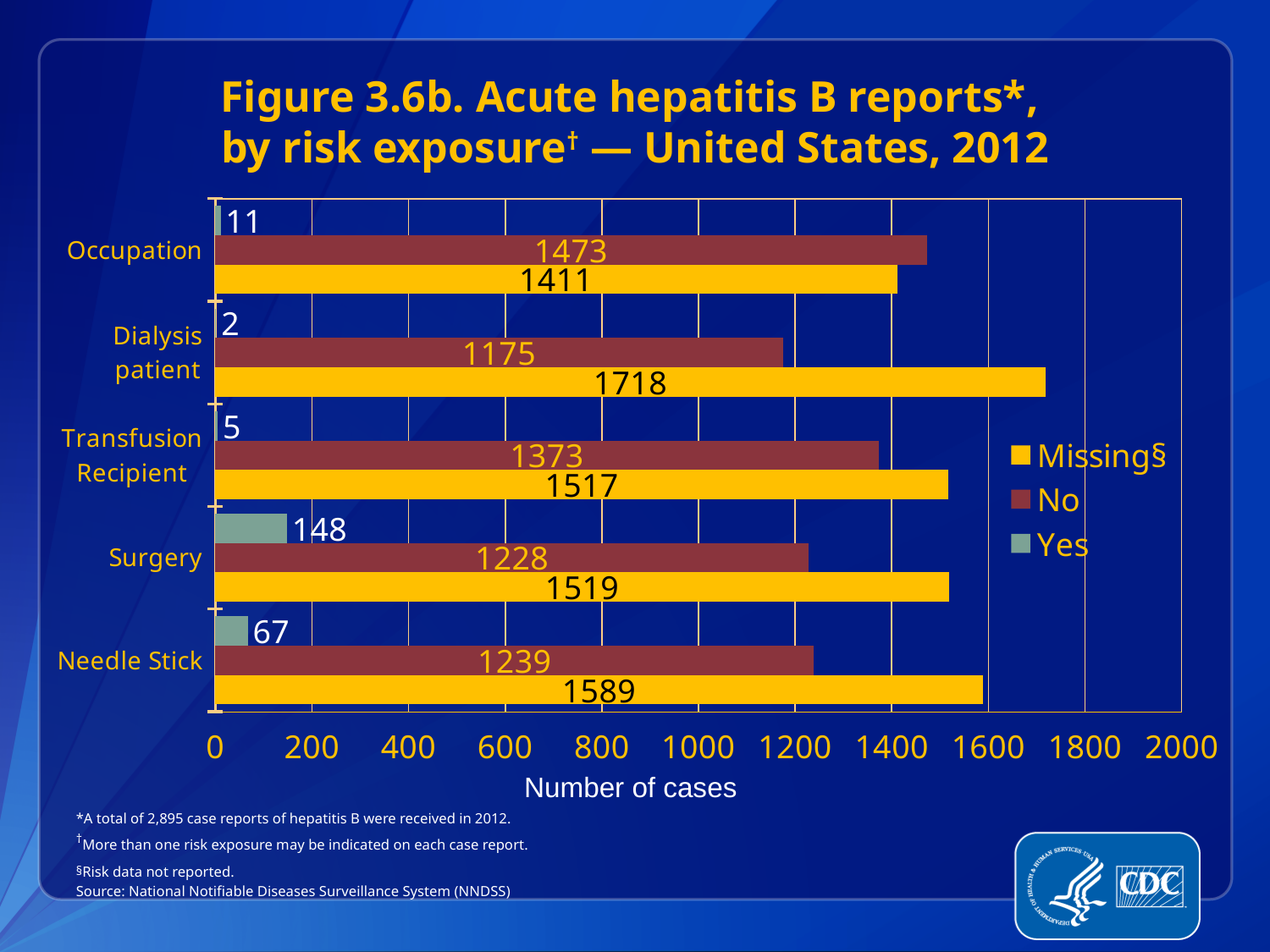
How many series does the legend list? 3 What is the number of cases for the 'Missing' series for Dialysis patient? 1718 Which risk exposure category has the lowest value in the 'No' series? Dialysis patient What is the difference between the 'Missing' and 'No' values for Needle Stick? 350 How many risk exposure categories are shown on the chart? 5 Which risk exposure category has the highest value in the 'Yes' series? Surgery What is the number of cases for the 'No' series for Occupation? 1473 What is the label of the x axis? Number of cases For Occupation, which is larger: the 'No' value or the 'Missing' value? No What is the number of cases for the 'Yes' series for Surgery? 148 What is the number of cases for the 'Yes' series for Needle Stick? 67 What kind of chart is shown on the slide? Bar chart